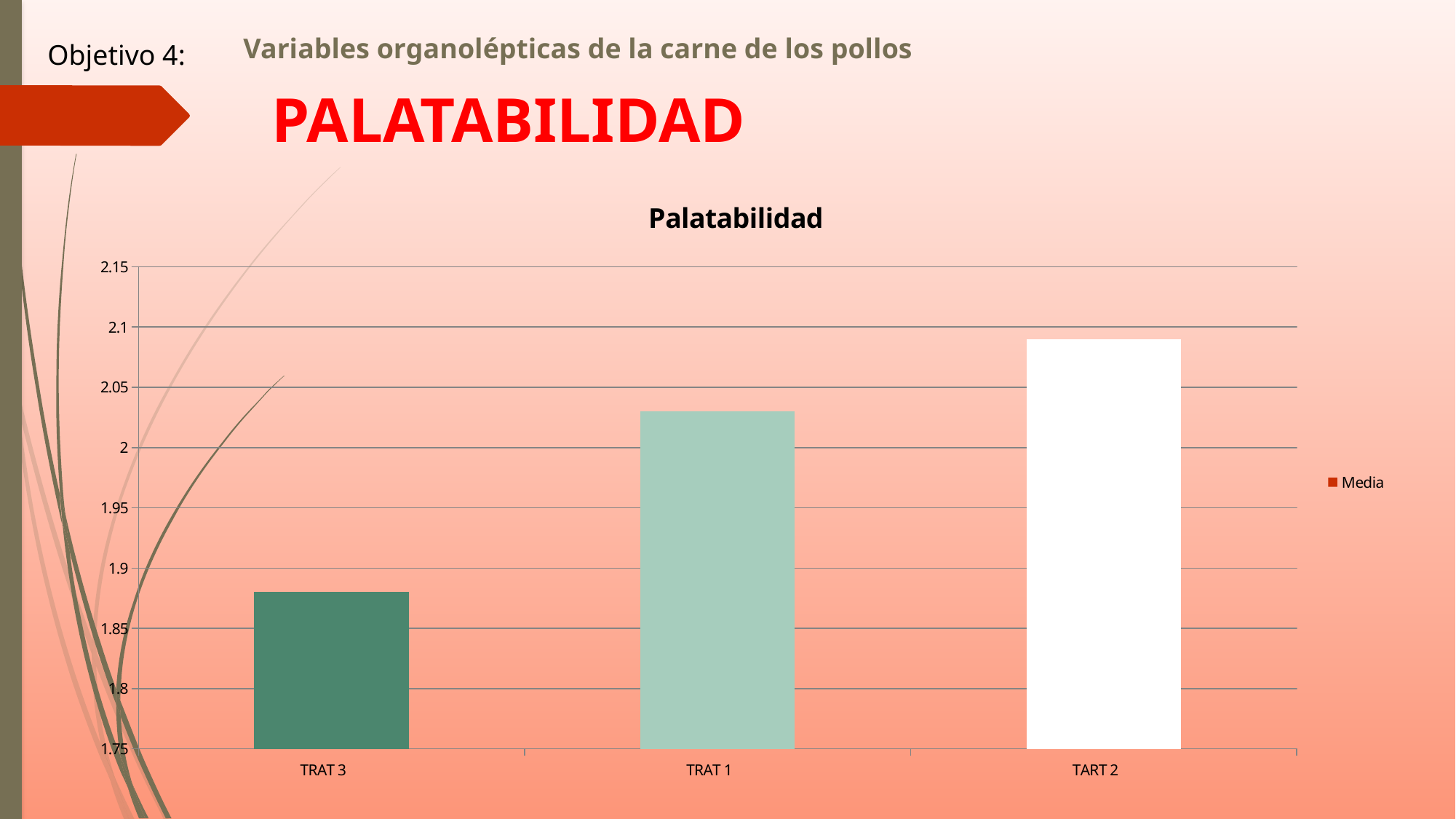
Which category has the highest bar in the chart? TART 2 Is the value for TART 2 greater or less than 2.05? greater Do the bar values rise or fall from left to right along the x axis? rise How many categories are plotted on the x axis of the chart? 3 Is the value for TRAT 3 greater or less than 1.9? less Which category has the lowest bar in the chart? TRAT 3 How many series does the chart's legend list? 1 What is the title of the chart? Palatabilidad What is the name of the series shown in the chart's legend? Media What kind of chart is shown on the slide? bar chart Which has the larger value, TRAT 1 or TRAT 3? TRAT 1 Is the value for TRAT 1 greater or less than 2? greater